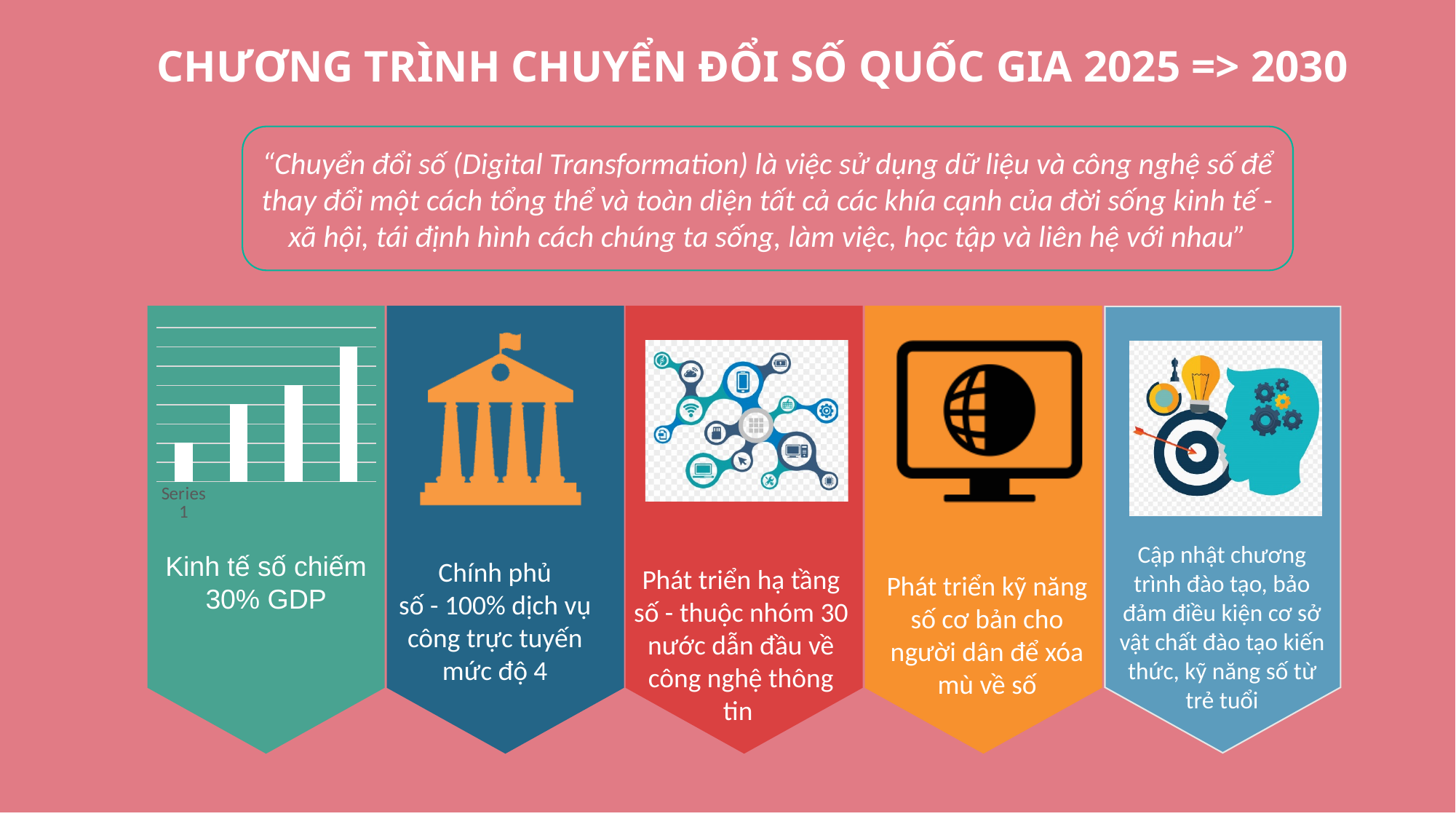
What colour are the bars in the chart in the green banner? white Which bar in the chart in the green banner is the shortest? the first (leftmost) bar What kind of chart is shown in the green banner on the left of the slide? bar chart How many bars does the chart in the green banner show? 4 In the chart in the green banner, is the second bar or the third bar taller? the third bar Do the bars in the chart in the green banner rise or fall from left to right? rise What label is printed below the chart in the green banner? Series 1 Which bar in the chart in the green banner is the tallest? the fourth (rightmost) bar